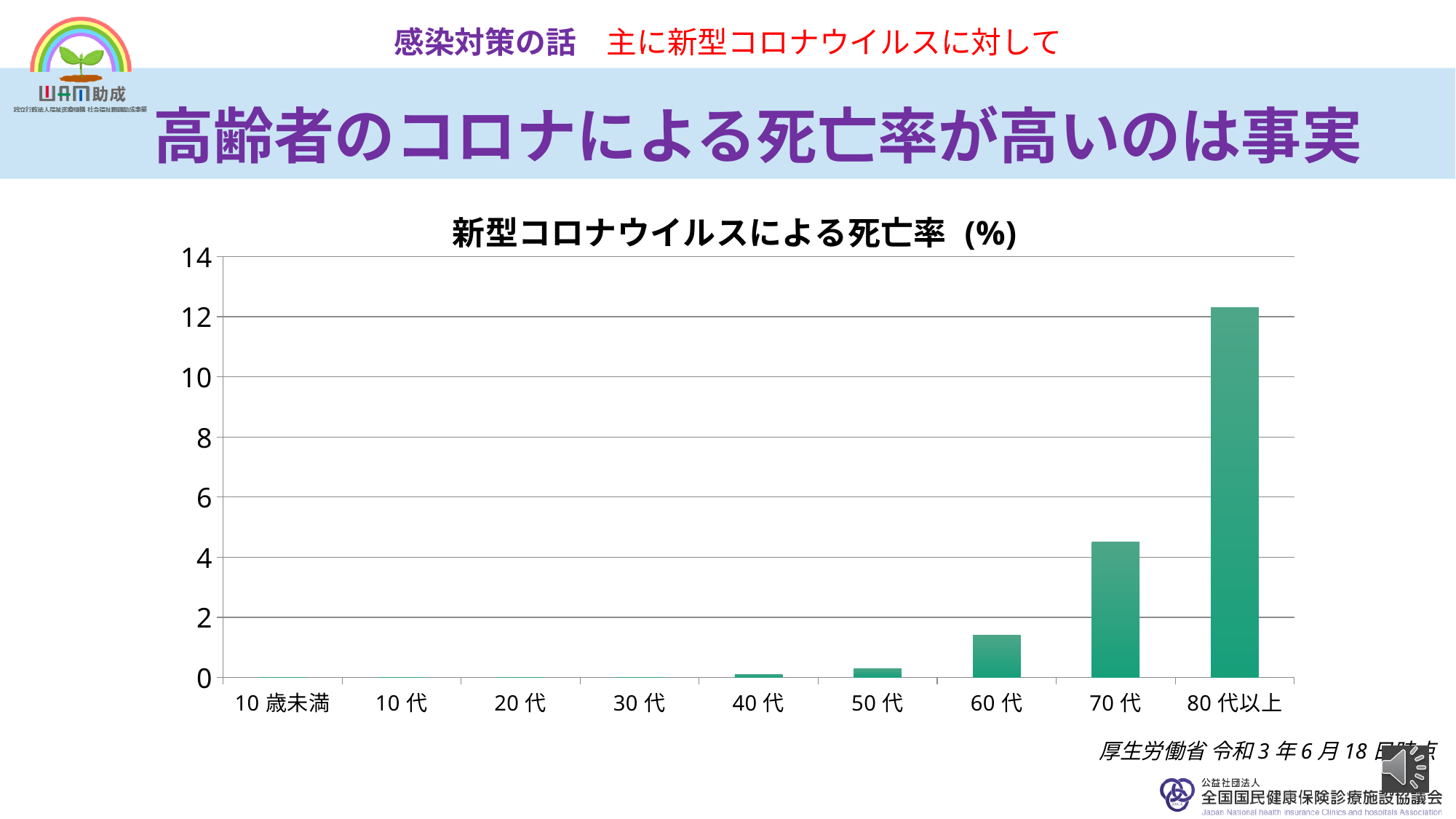
Which is larger, the death rate for 80代以上 or for 70代? 80代以上 What is the highest value shown on the y axis of the chart? 14 What kind of chart is shown on the slide? bar chart Which is larger, the death rate for 60代 or for 50代? 60代 Is the value for 80代以上 greater or less than 10? greater Is the value for 70代 greater or less than 6? less How many age categories are shown on the x axis of the chart? 9 Is the value for 70代 greater or less than 4? greater What is the title of the chart? 新型コロナウイルスによる死亡率（%） Do the death rates rise or fall as age increases along the x axis? rise Which age category has the highest death rate in the chart? 80代以上